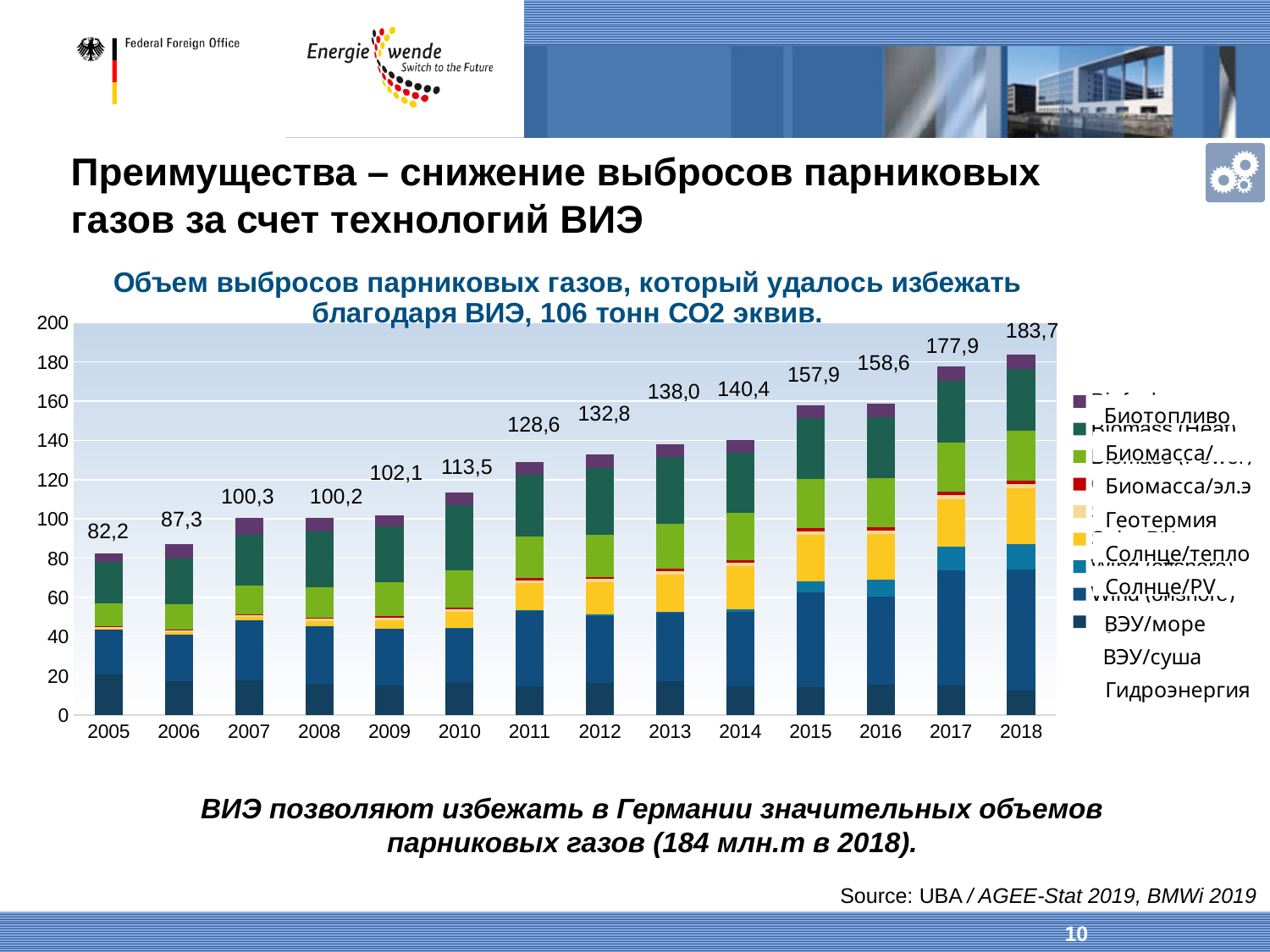
Which year has a larger total, 2010 or 2013? 2013 What is the difference between the total for 2017 and the total for 2016? 19,3 Is the total value for 2014 greater or less than 160? less What is the total value shown for 2011? 128,6 How many years are shown on the x axis? 14 What is the total value shown for 2018? 183,7 Which year has the highest total value? 2018 What is the difference between the total for 2018 and the total for 2005? 101,5 Do the total values generally rise or fall from 2005 to 2018? Rise What is the total value shown for 2005? 82,2 What kind of chart is shown on the slide? Stacked bar chart Which year has the lowest total value? 2005